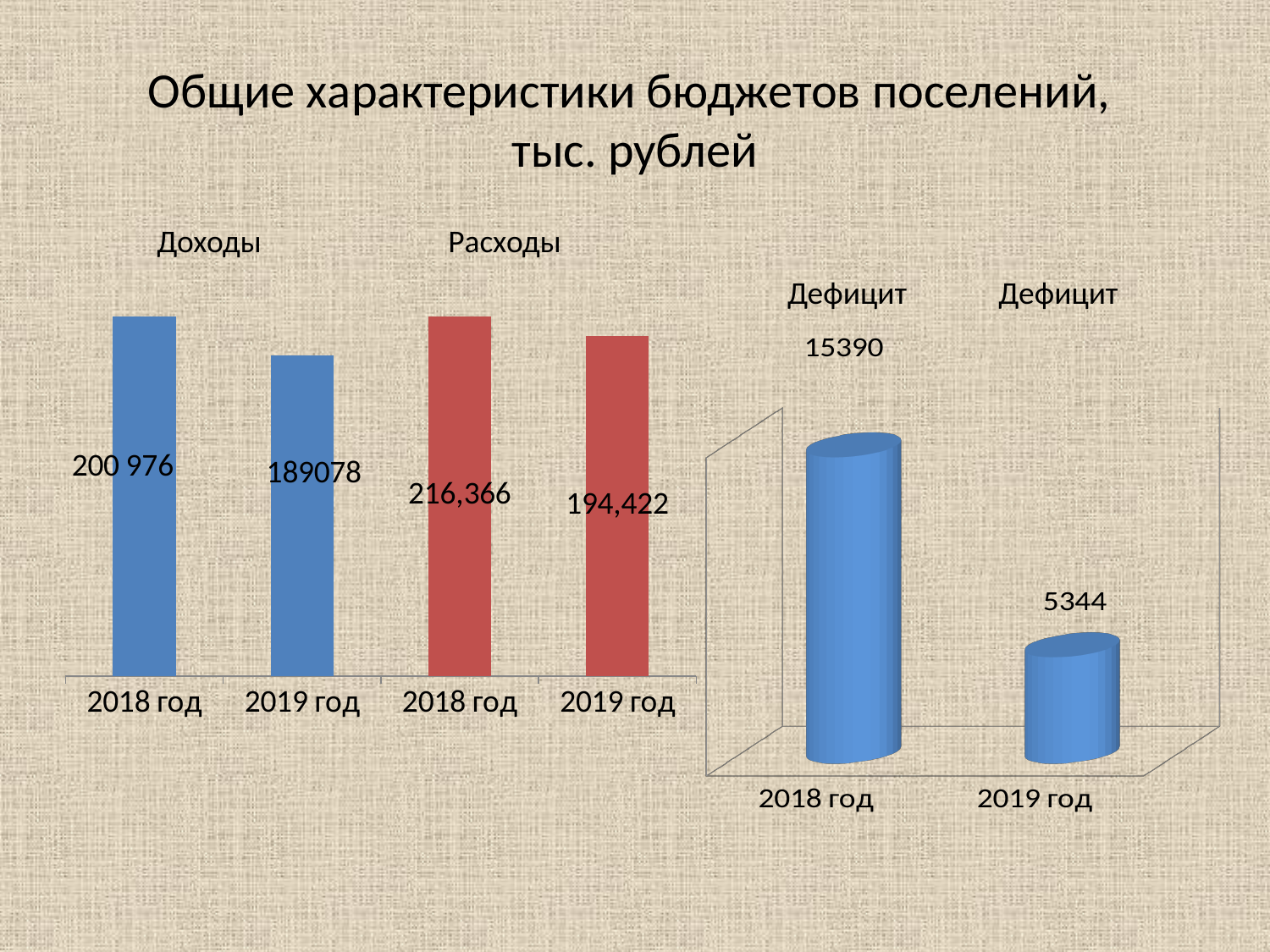
What kind of chart is the right chart (Дефицит)? bar chart In the right chart (Дефицит), what is the value for 2019 год? 5344 In the right chart (Дефицит), which year has the higher value? 2018 год In the left chart, what is the value of Доходы for 2018 год? 200 976 In the left chart, what is the value of Расходы for 2019 год? 194,422 In the left chart, what colour are the Расходы bars? red In the left chart, what is the value of Расходы for 2018 год? 216,366 In the left chart, do the Доходы values rise or fall from 2018 год to 2019 год? fall In the right chart (Дефицит), what is the difference between the 2018 год and 2019 год values? 10046 In the left chart, what is the value of Доходы for 2019 год? 189078 In the left chart, which is larger: Расходы for 2018 год or Доходы for 2018 год? Расходы for 2018 год In the right chart (Дефицит), what is the value for 2018 год? 15390